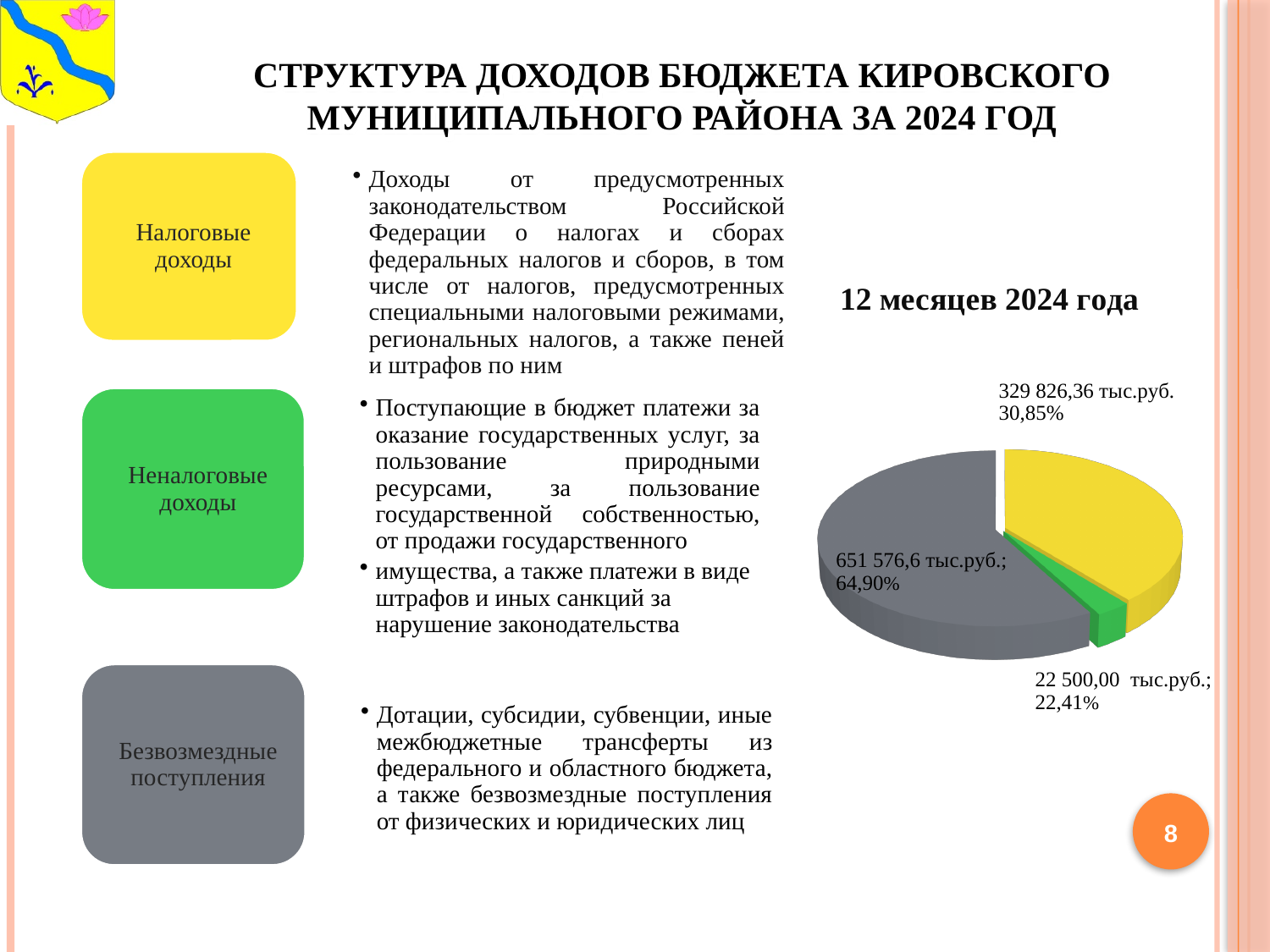
What percentage is labelled on the yellow slice of the pie chart? 30,85% How many slices does the pie chart have? 3 What is the title shown above the pie chart? 12 месяцев 2024 года What type of chart is shown on the slide? Pie chart What percentage is labelled on the grey slice of the pie chart? 64,90% What value is labelled on the yellow slice of the pie chart? 329 826,36 тыс.руб. What is the difference between the grey slice value and the yellow slice value in the pie chart? 321 750,24 тыс.руб. Which slice of the pie chart has the smallest value? The green slice (22 500,00 тыс.руб.) Which is larger in the pie chart: the yellow slice or the grey slice? The grey slice Which slice of the pie chart has the largest value? The grey slice (651 576,6 тыс.руб.) What value is labelled on the grey slice of the pie chart? 651 576,6 тыс.руб. What value is labelled on the green slice of the pie chart? 22 500,00 тыс.руб.